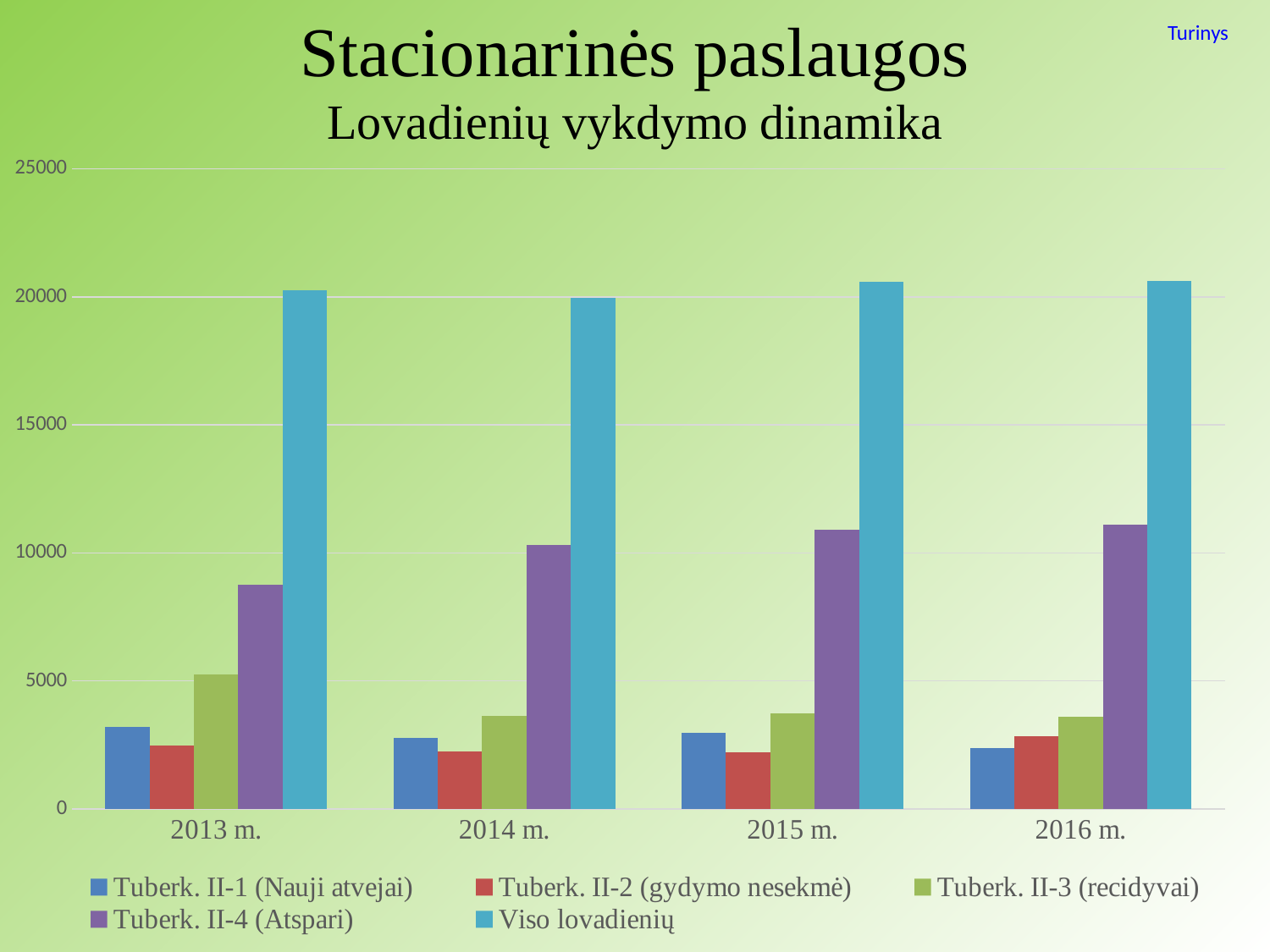
Which series has the lowest value in 2013 m.? Tuberk. II-2 (gydymo nesekmė) Is the value for Tuberk. II-4 (Atspari) in 2016 m. greater or less than 10000? greater Which series has the highest value in 2013 m.? Viso lovadienių What kind of chart is shown on the slide? bar chart Is the value for Viso lovadienių in 2013 m. greater or less than 15000? greater Which is larger for Tuberk. II-1 (Nauji atvejai): the value in 2013 m. or in 2016 m.? 2013 m. Does the value for Tuberk. II-4 (Atspari) rise or fall from 2013 m. to 2016 m.? rise Is the value for Tuberk. II-2 (gydymo nesekmė) in 2015 m. greater or less than 5000? less How many series does the legend list? 5 How many year categories are shown on the x axis? 4 What is the subtitle of the chart shown on the slide? Lovadienių vykdymo dinamika